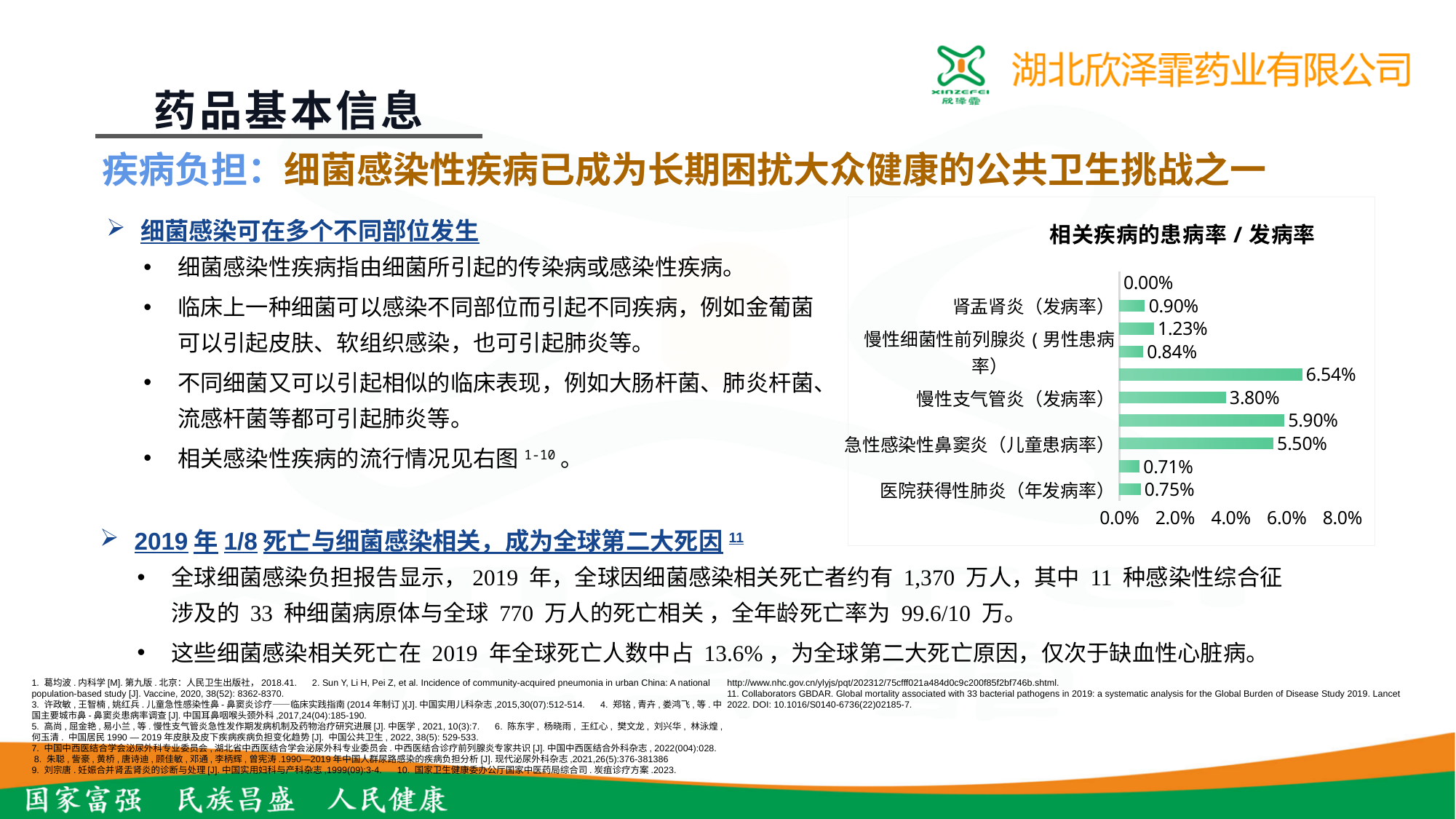
What value is shown for 医院获得性肺炎（年发病率）? 0.75% What value is shown for 急性感染性鼻窦炎（儿童患病率）? 5.50% What is the smallest value labelled on any bar in the chart? 0.00% Which is larger, the value for 慢性支气管炎（发病率） or the value for 急性感染性鼻窦炎（儿童患病率）? 急性感染性鼻窦炎（儿童患病率） What value is shown for 慢性支气管炎（发病率）? 3.80% What is the difference between the largest bar value (6.54%) and the value for 慢性支气管炎（发病率）? 2.74% What is the largest value labelled on any bar in the chart? 6.54% What kind of chart is shown on the slide? bar chart How many bars are plotted in the chart? 10 What is the title of the chart on the right of the slide? 相关疾病的患病率 / 发病率 What is the highest tick value shown on the horizontal axis of the chart? 8.0% What value is shown for 肾盂肾炎（发病率）? 0.90%